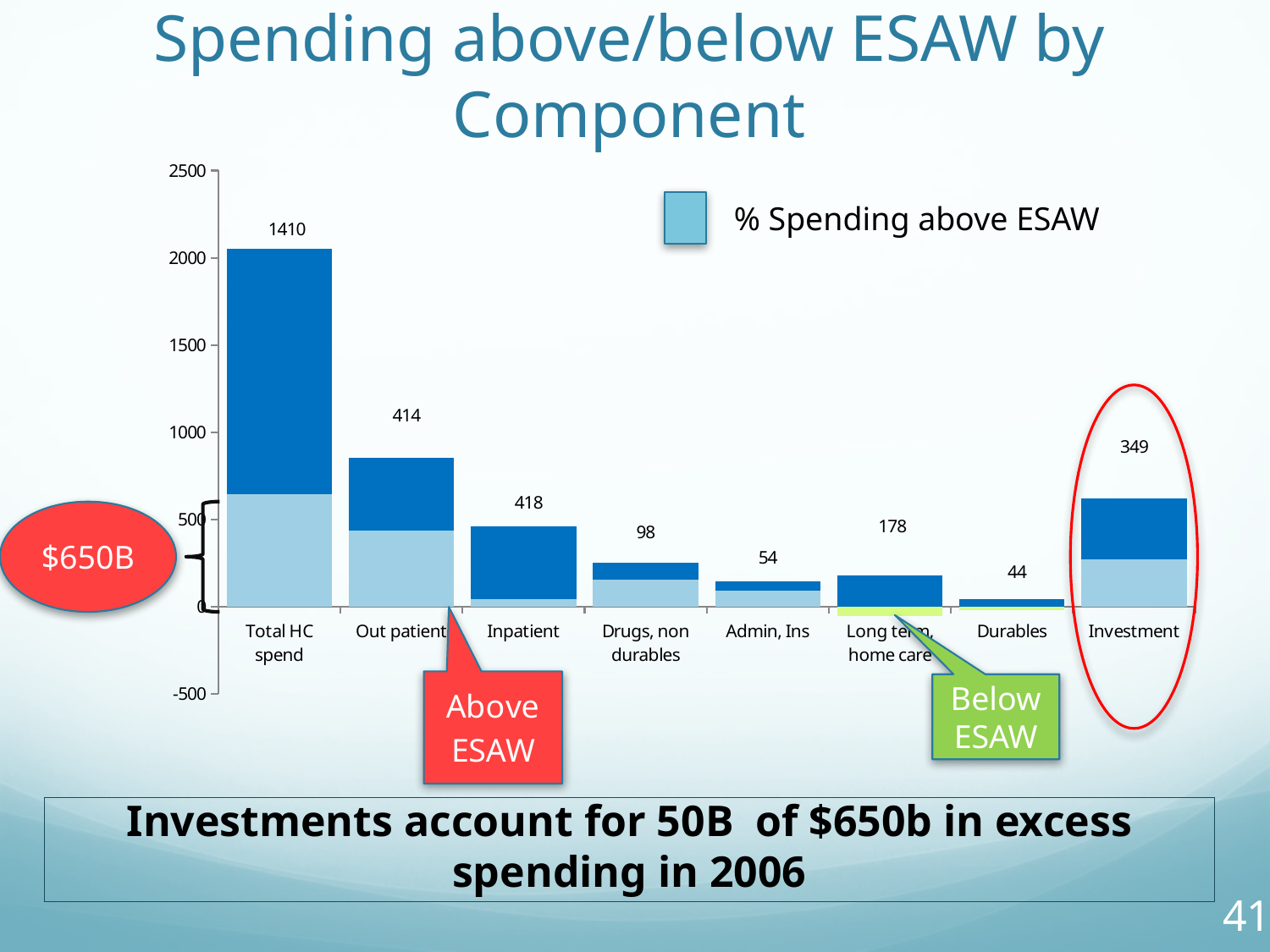
What value is labelled above the bar for Investment? 349 Which category has the lowest labelled value? Durables What is the difference between the labelled values for Total HC spend and Out patient? 996 What value is labelled above the bar for Long term home care? 178 What value is labelled above the bar for Total HC spend? 1410 Which has the larger labelled value, Investment or Drugs, non durables? Investment What kind of chart is shown on the slide? bar chart Is the total height of the Out patient bar greater or less than 500? greater How many series does the chart's legend list? 1 What is the entry shown in the chart's legend? % Spending above ESAW Which category has the highest labelled value? Total HC spend How many categories are shown along the x axis of the chart? 8